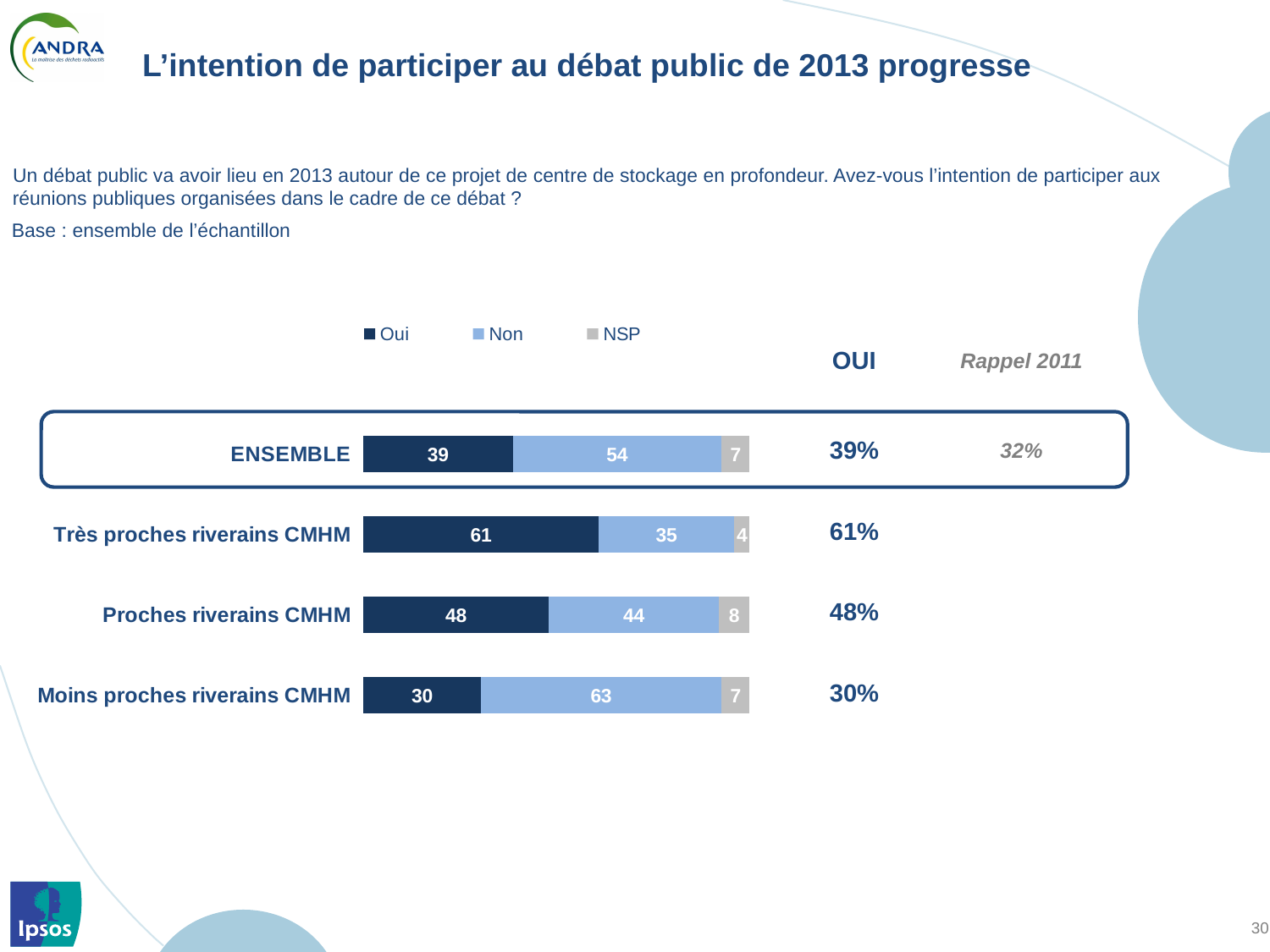
What is the Oui value for ENSEMBLE? 39 What is the NSP value for Proches riverains CMHM? 8 Which category has the highest Oui value? Très proches riverains CMHM What is the difference between the Oui values for Très proches riverains CMHM and Proches riverains CMHM? 13 How many series does the legend list? 3 How many categories are shown in the chart? 4 What is the Non value for Très proches riverains CMHM? 35 What is the Non value for Moins proches riverains CMHM? 63 What kind of chart is shown on the slide? Stacked bar chart Which category has the lowest Oui value? Moins proches riverains CMHM Which is larger: the Non value for ENSEMBLE or the Non value for Proches riverains CMHM? ENSEMBLE What is the total of the stacked bar for Proches riverains CMHM? 100